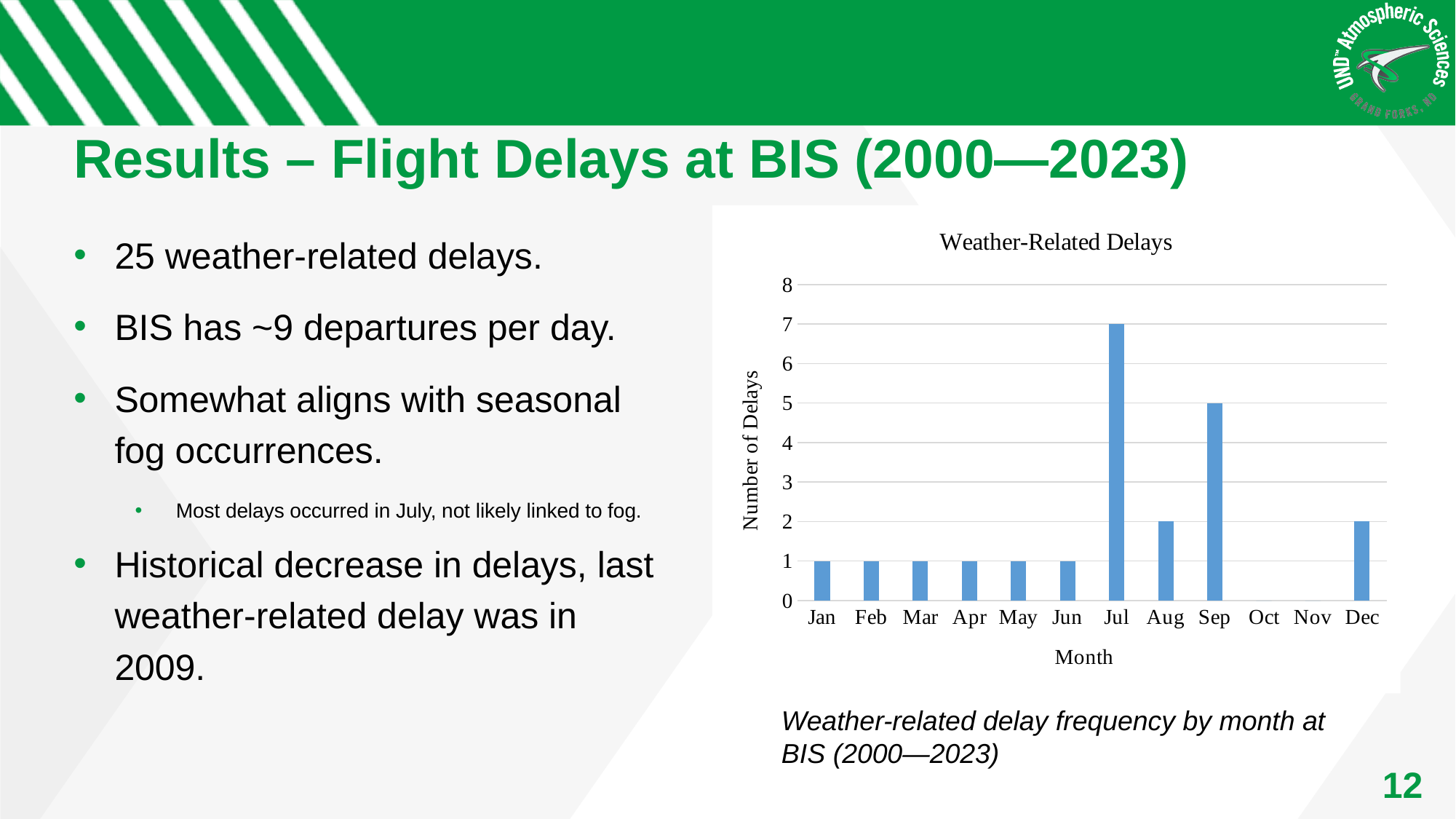
Is the value for Jul greater or less than 6? greater What is the number of delays for Sep? 5 Which month has the highest number of delays? Jul What is the number of delays for Oct? 0 What is the number of delays for Aug? 2 What is the number of delays for Jul? 7 How many months are shown on the x axis? 12 What is the label of the y axis? Number of Delays What is the difference in number of delays between Jul and Sep? 2 What is the title of the chart? Weather-Related Delays What kind of chart is shown on the slide? Bar chart Which has more delays, Sep or Aug? Sep